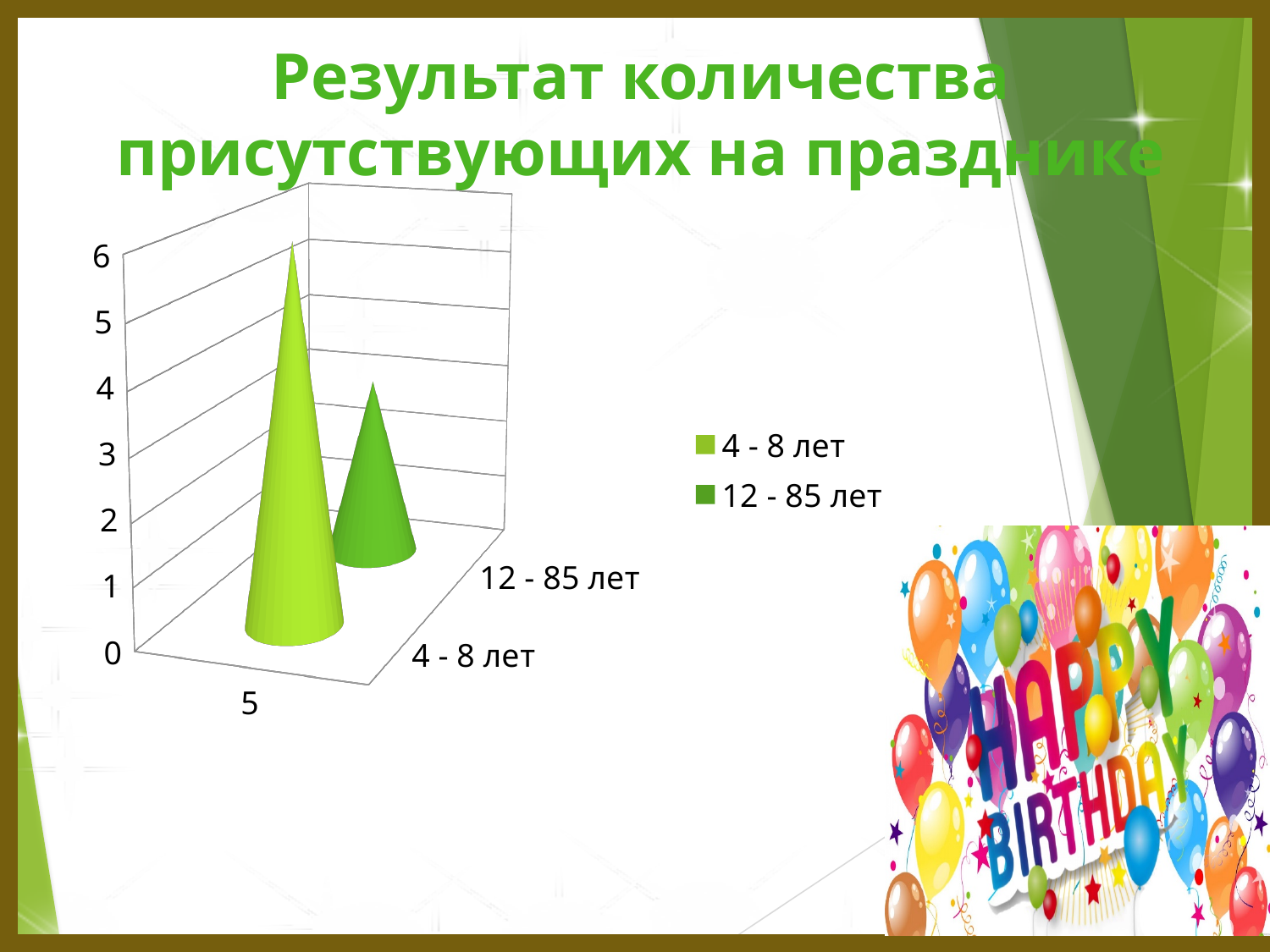
What is the highest value shown on the vertical axis of the chart? 6 Which series has the lowest value in the chart? 12 - 85 лет Is the value for 12 - 85 лет greater or less than 6? less What kind of chart is shown on the slide? bar chart Is the value for 4 - 8 лет greater or less than 3? greater Which series has the highest value in the chart? 4 - 8 лет How many series does the chart legend list? 2 What are the two series named in the chart legend? 4 - 8 лет and 12 - 85 лет How many categories are shown along the horizontal axis of the chart? 1 Is the value for 12 - 85 лет greater or less than 2? greater What is the title of the chart on the slide? Результат количества присутствующих на празднике Which series has the taller bar, 4 - 8 лет or 12 - 85 лет? 4 - 8 лет